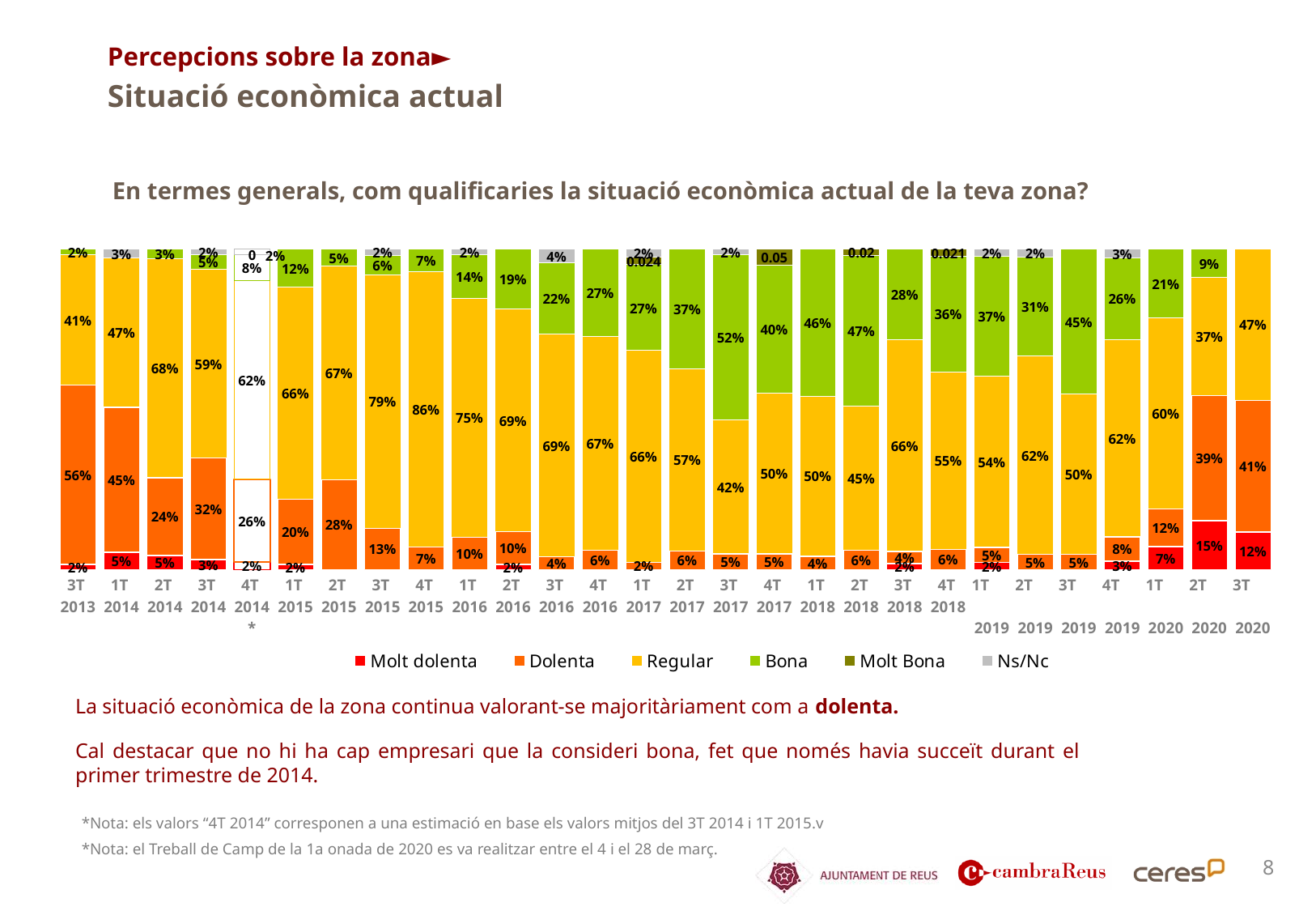
What share of respondents answered 'Bona' in 3T 2017? 52% What percentage of respondents rated the situation as 'Regular' in 4T 2015? 86% In 3T 2020, which is larger: the 'Dolenta' share or the 'Regular' share? Regular What is the 'Molt dolenta' value for 2T 2020? 15% In which quarter is the 'Bona' share the highest? 3T 2017 What is the 'Dolenta' value for 3T 2013? 56% By how many percentage points does the 'Regular' value in 3T 2020 exceed that of 2T 2020? 10 percentage points How many series does the legend list? 6 What kind of chart is shown on the slide? Stacked bar chart How many quarters (bars) are plotted in the chart? 28 Which colour represents the 'Bona' category in the legend? Green In which quarter does the 'Regular' category reach its highest value? 4T 2015